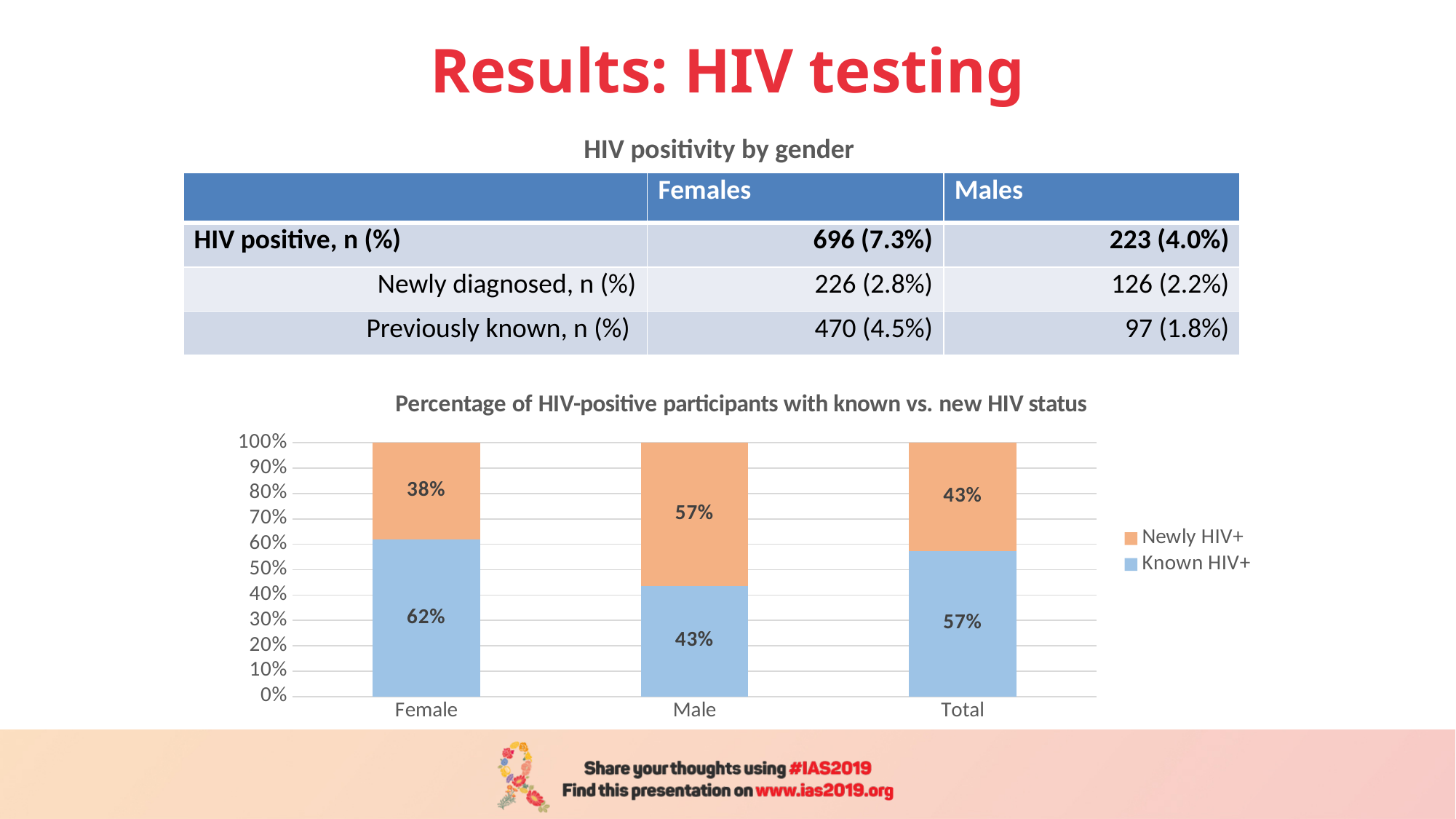
What is the difference between the Known HIV+ values for Female and Male? 19% How many categories are shown on the x axis? 3 Which category has the highest Known HIV+ value? Female How many series does the legend list? 2 What is the title of the chart? Percentage of HIV-positive participants with known vs. new HIV status What is the Newly HIV+ value for Male? 57% What is the Known HIV+ value for Female? 62% What is the Newly HIV+ value for Female? 38% What is the Known HIV+ value for Total? 57% Which category has the lowest Newly HIV+ value? Female What kind of chart is shown? Stacked bar chart Is the Newly HIV+ value larger for Male or for Total? Male